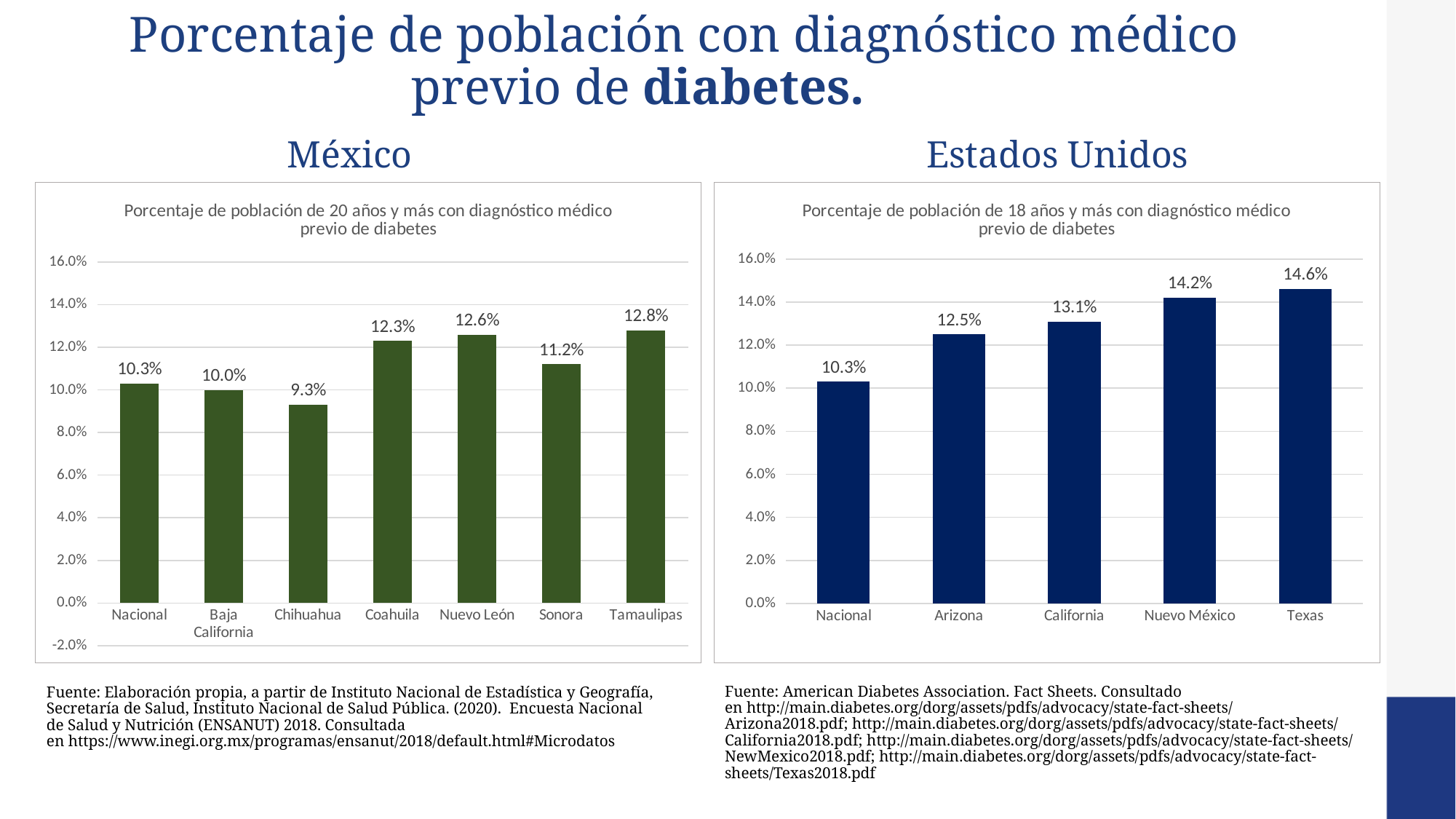
In the México chart, which category has the highest value? Tamaulipas How many categories are shown in the México chart? 7 In the México chart, what is the difference between the values for Tamaulipas and Chihuahua? 3.5% In the México chart, what is the value for Chihuahua? 9.3% In the México chart, which category has the lowest value? Chihuahua In the Estados Unidos chart, what is the value for Nuevo México? 14.2% In the México chart, which is larger, the value for Coahuila or the value for Sonora? Coahuila How many categories are shown in the Estados Unidos chart? 5 What kind of chart is the Estados Unidos chart? Bar chart In the Estados Unidos chart, which category has the lowest value? Nacional In the Estados Unidos chart, what is the difference between the values for Texas and Nacional? 4.3% In the Estados Unidos chart, which category has the highest value? Texas